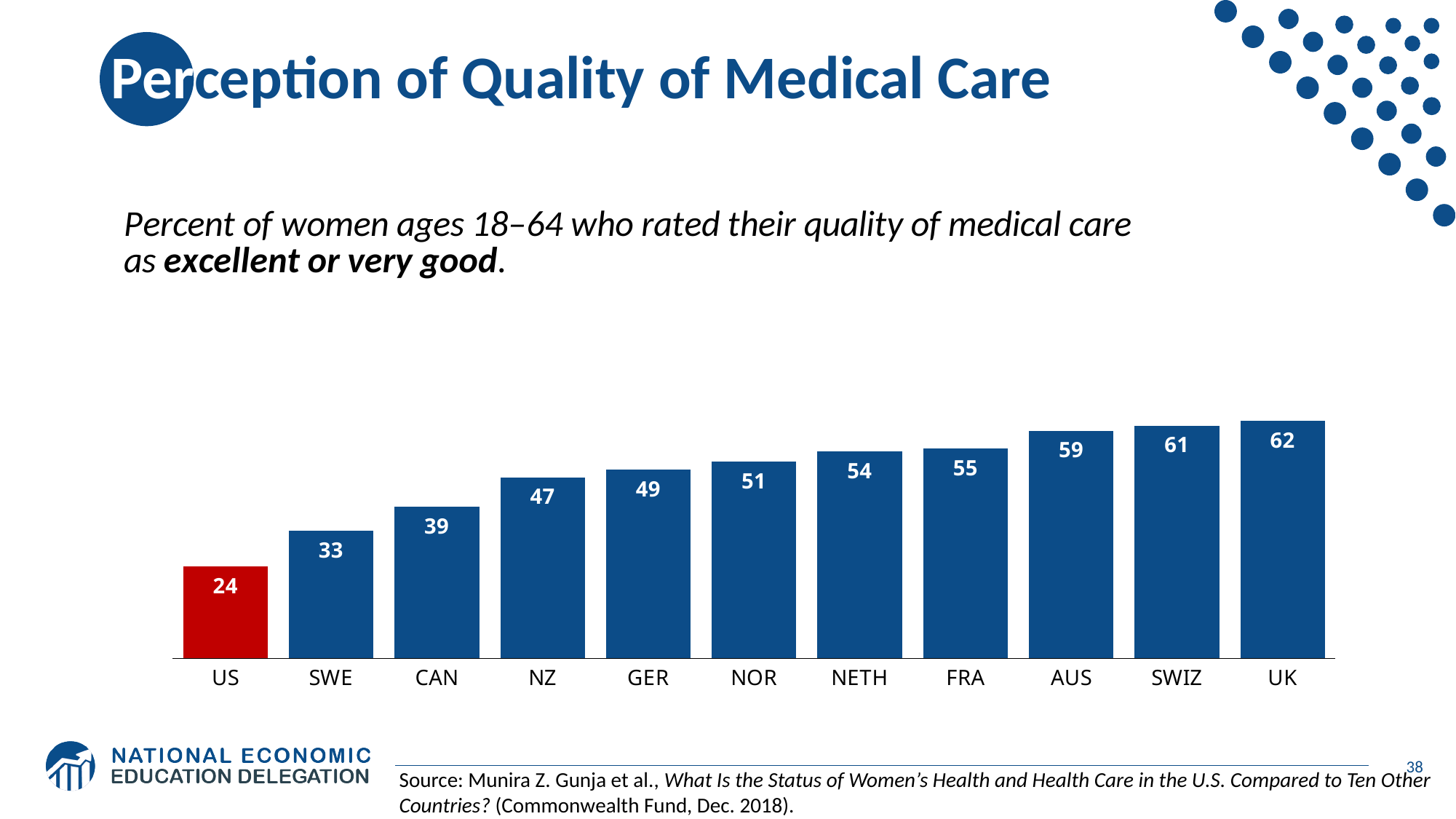
What is the difference between the values for UK and US? 38 What kind of chart is shown on the slide? bar chart What is the value for the US? 24 What is the value for GER? 49 What is the value for AUS? 59 Which has a larger value, NOR or NZ? NOR How many countries are shown in the chart? 11 What is the difference between the values for CAN and SWE? 6 Do the values rise or fall from left to right along the x axis? rise Which country has the lowest value? US Which bar is coloured red rather than blue? US Which country has the highest value? UK